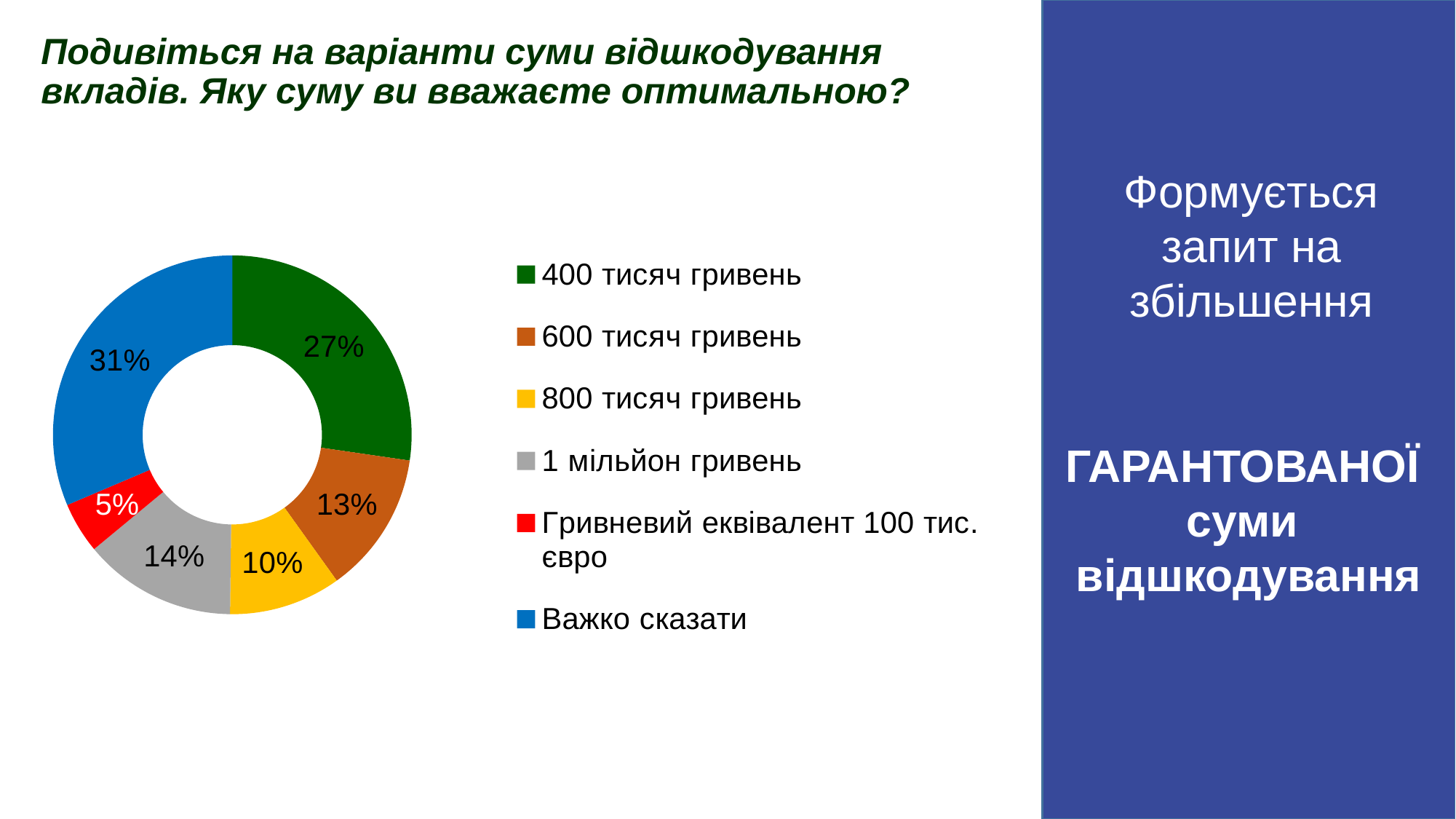
What share of respondents chose Гривневий еквівалент 100 тис. євро? 5% What share of respondents chose 1 мільйон гривень? 14% How many categories does the chart show? 6 What share of respondents answered Важко сказати? 31% What share of respondents chose 600 тисяч гривень? 13% Which category has the largest share in the chart? Важко сказати What type of chart is shown on the slide? Doughnut (pie) chart Which category has the smallest share in the chart? Гривневий еквівалент 100 тис. євро What share of respondents chose 400 тисяч гривень? 27% Which has a larger share: 1 мільйон гривень or 800 тисяч гривень? 1 мільйон гривень What share of respondents chose 800 тисяч гривень? 10% What is the difference in percentage points between the shares for 400 тисяч гривень and 600 тисяч гривень? 14